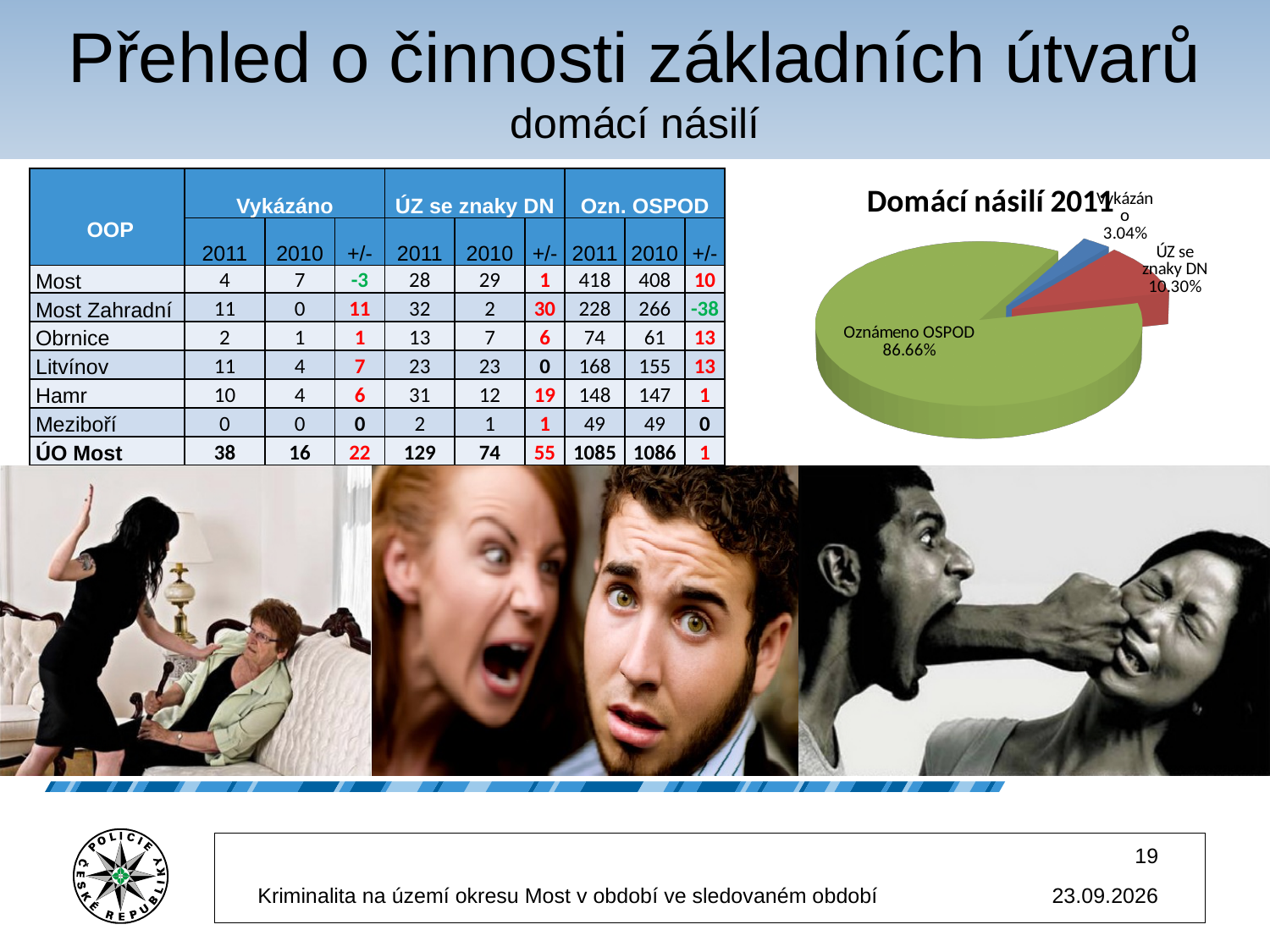
What kind of chart is shown on the slide? pie chart How many slices does the pie chart have? 3 What is the difference in percentage points between the Oznámeno OSPOD slice and the ÚZ se znaky DN slice? 76.36 What colour is the Oznámeno OSPOD slice in the pie chart? green What is the title of the pie chart? Domácí násilí 2011 Which slice of the pie chart is the smallest? Vykázáno What share of the pie does Oznámeno OSPOD have? 86.66% Which is larger in the pie chart, ÚZ se znaky DN or Vykázáno? ÚZ se znaky DN What share of the pie does ÚZ se znaky DN have? 10.30% What share of the pie does Vykázáno have? 3.04% Which slice of the pie chart is the largest? Oznámeno OSPOD